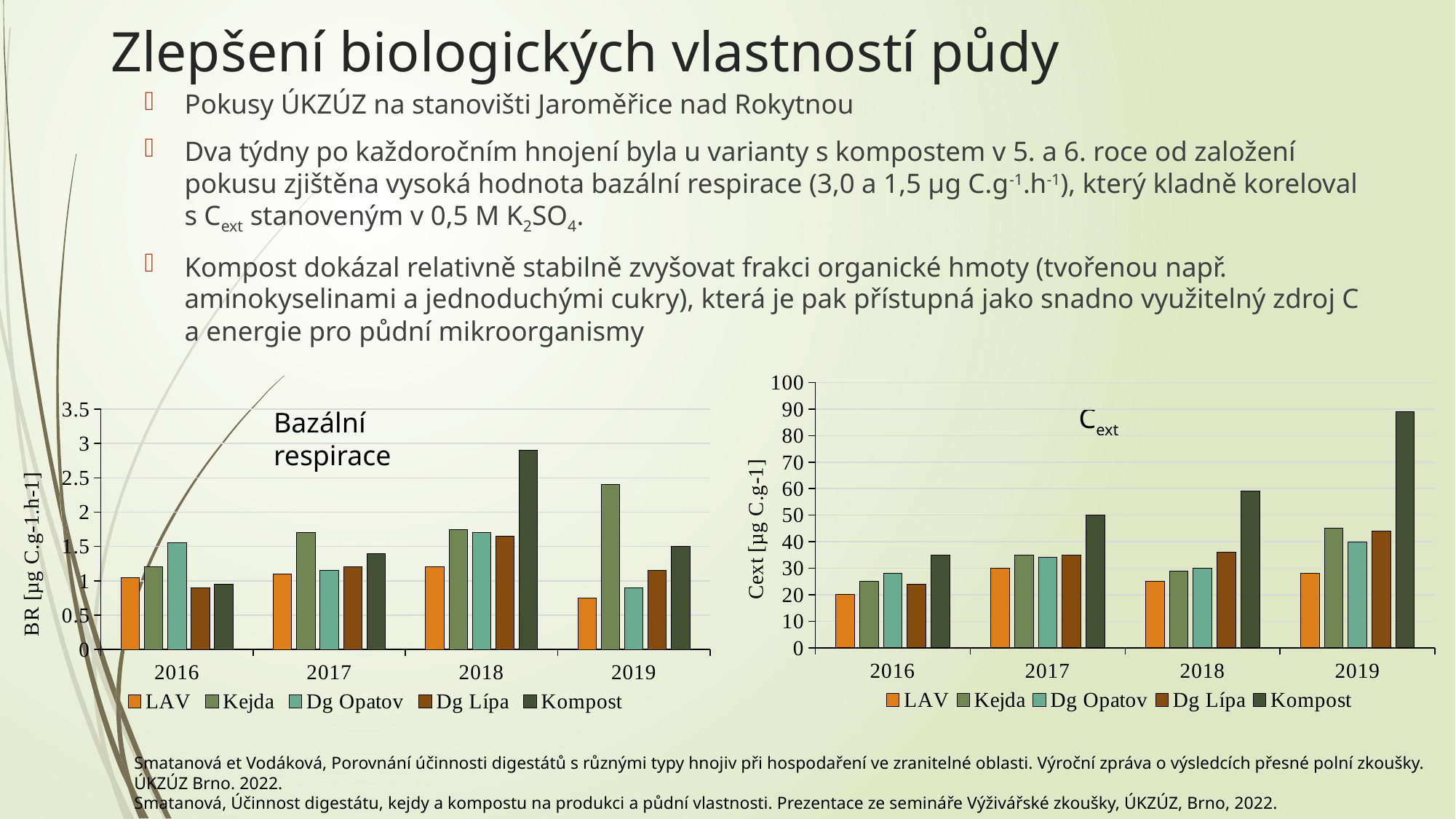
In the Bazální respirace chart, is the value for LAV in 2019 greater or less than 1? less In the Cext chart, what is the value for Kompost in 2017? 50 How many years are shown on the x axis of the Bazální respirace chart? 4 In the Bazální respirace chart, which series has the highest value in 2018? Kompost In the Bazální respirace chart, is the value for Kompost in 2018 greater or less than 2.5? greater In the Bazální respirace chart, which series has the highest value in 2019? Kejda How many series does the legend of the Cext chart list? 5 In the Cext chart, which series has the lowest value in 2016? LAV In the Cext chart, does the Kompost value rise or fall from 2016 to 2019? rise What kind of chart is the Bazální respirace chart on the left? bar chart In the Cext chart, is the value for Kompost in 2019 greater or less than 80? greater In the Cext chart, which series has the highest value in 2019? Kompost